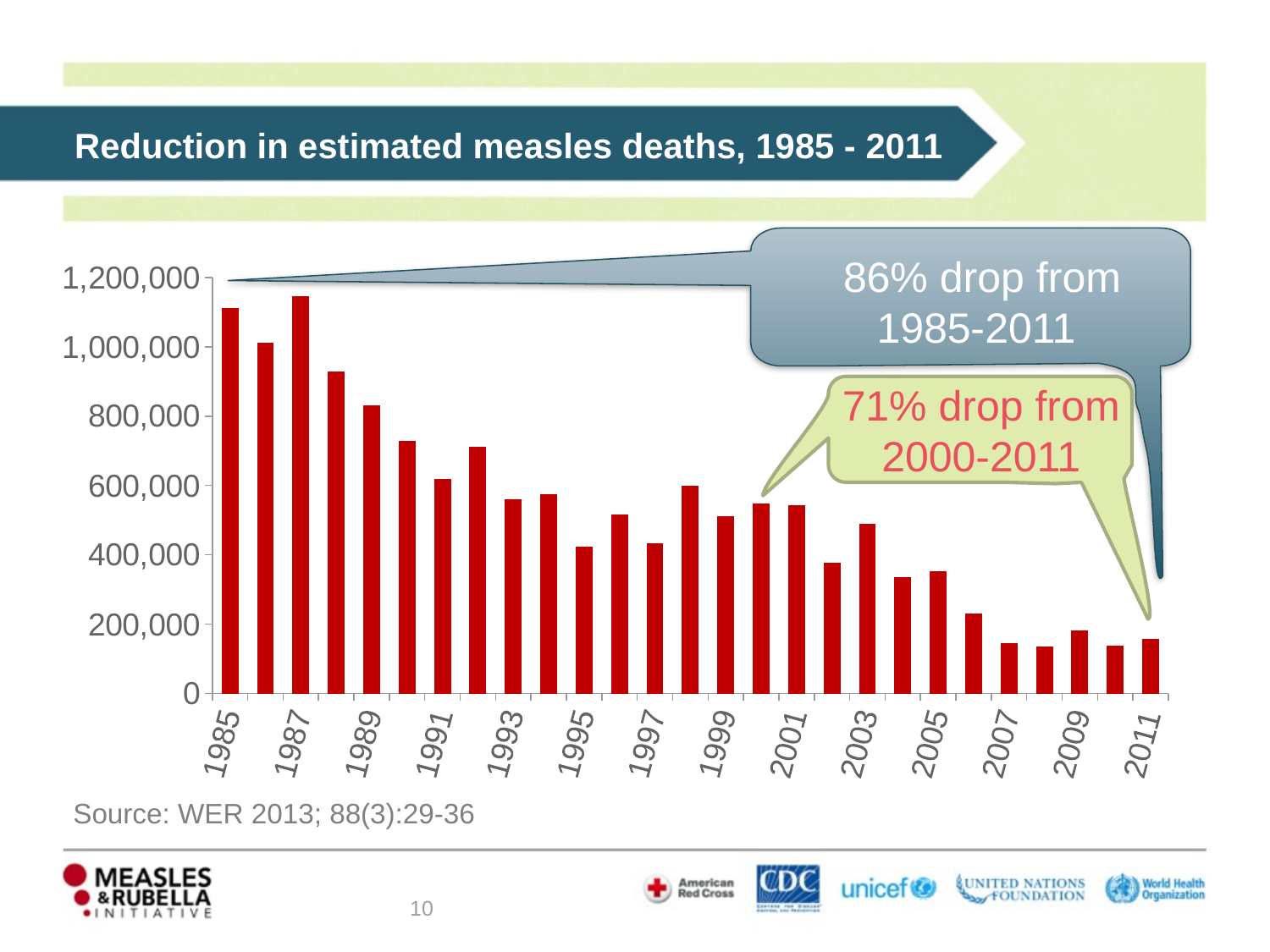
According to the callout on the chart, what percentage drop occurred from 1985 to 2011? 86% Which year has the highest bar in the chart? 1987 Is the value for 1995 greater or less than 600,000? less What is the title of the chart? Reduction in estimated measles deaths, 1985 - 2011 Is the value for 1999 greater or less than 400,000? greater Which year has the larger value, 1985 or 2011? 1985 Is the value for 2005 greater or less than 400,000? less What kind of chart is shown on the slide? bar chart Do the values generally rise or fall from 1985 to 2011? fall Which year has the larger value, 1997 or 1999? 1999